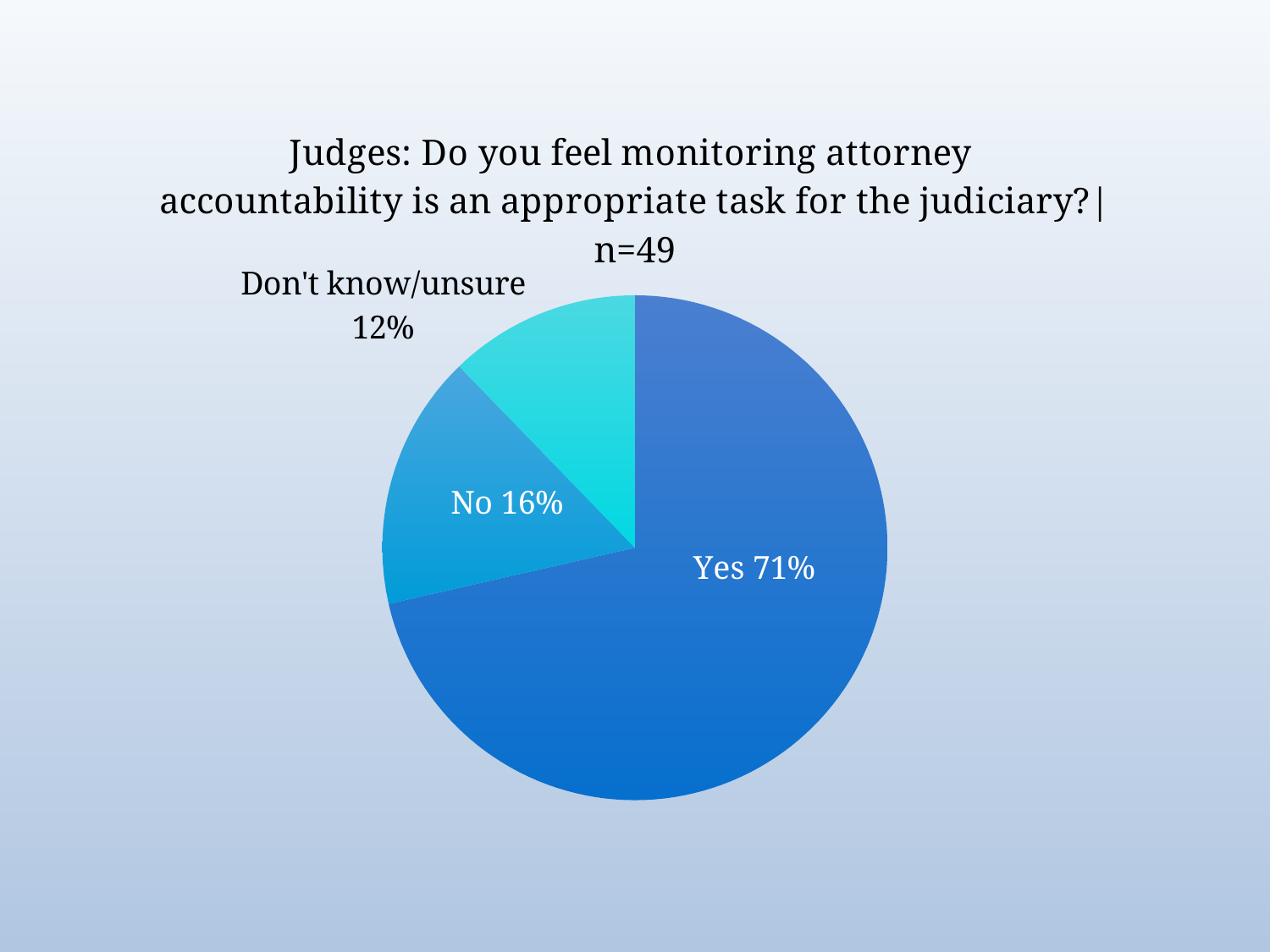
What percentage of judges answered No? 16% What share of the pie does the Yes slice represent? 71% Which is larger, the share for No or the share for Don't know/unsure? No Which response has the largest share of the pie? Yes How many judges responded to the survey question, according to the chart title? 49 What is the difference in percentage points between the Yes and No responses? 55 What percentage of judges answered Don't know/unsure? 12% What percentage of judges answered Yes? 71% How many response categories are shown in the pie chart? 3 What kind of chart is shown on the slide? Pie chart Which response has the smallest share of the pie? Don't know/unsure What is the difference in percentage points between the No and Don't know/unsure responses? 4